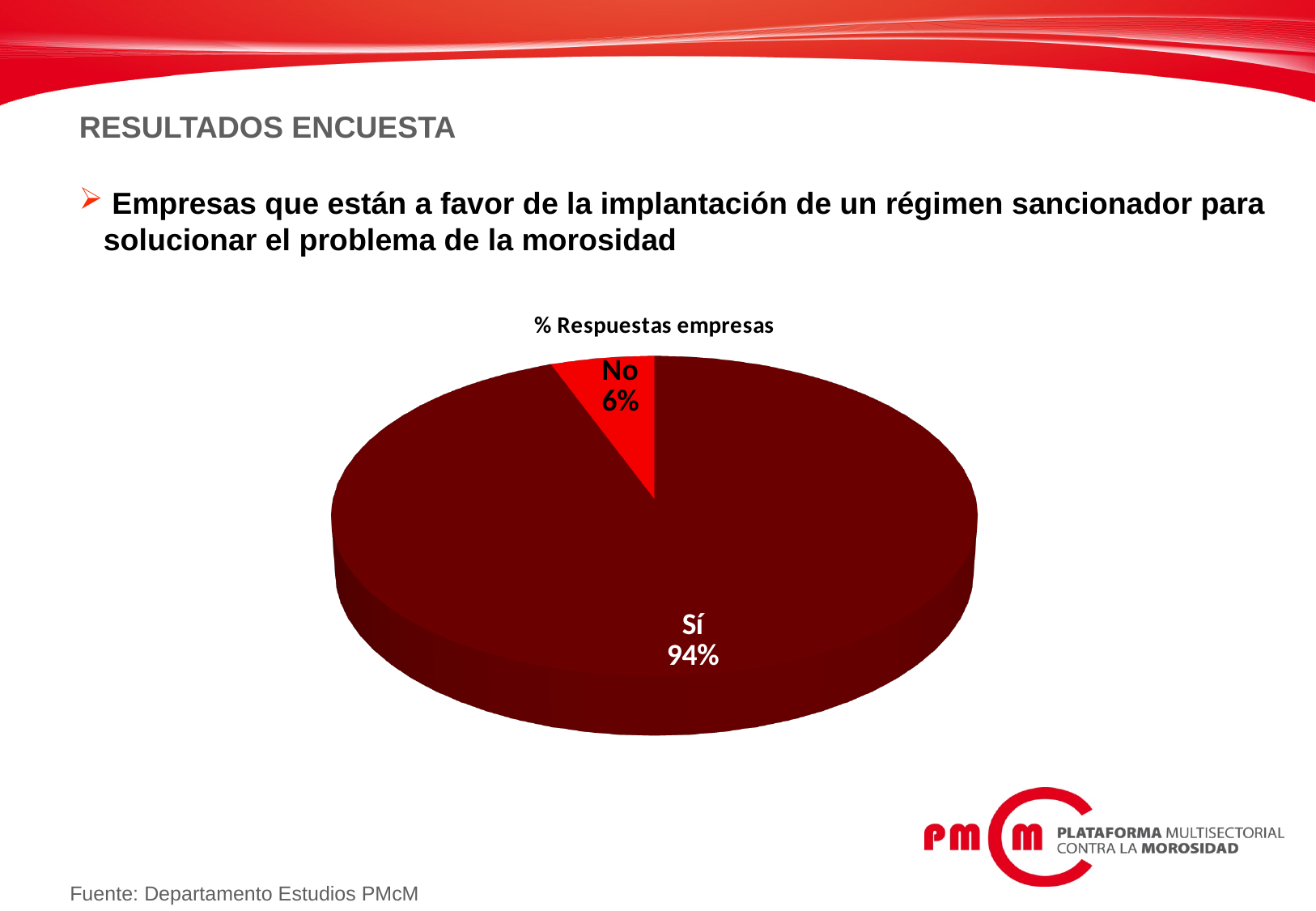
What colour is the "Sí" slice? dark red What percentage of companies answered "No"? 6% What share of the pie does the "No" slice represent? 6% Which response has the largest share of the pie? Sí What is the difference in percentage points between the "Sí" and "No" slices? 88 What is the title of the chart? % Respuestas empresas Which response has the smallest share of the pie? No What kind of chart is shown on the slide? pie chart Which slice is larger, "Sí" or "No"? Sí What percentage of companies answered "Sí"? 94% How many slices does the pie chart have? 2